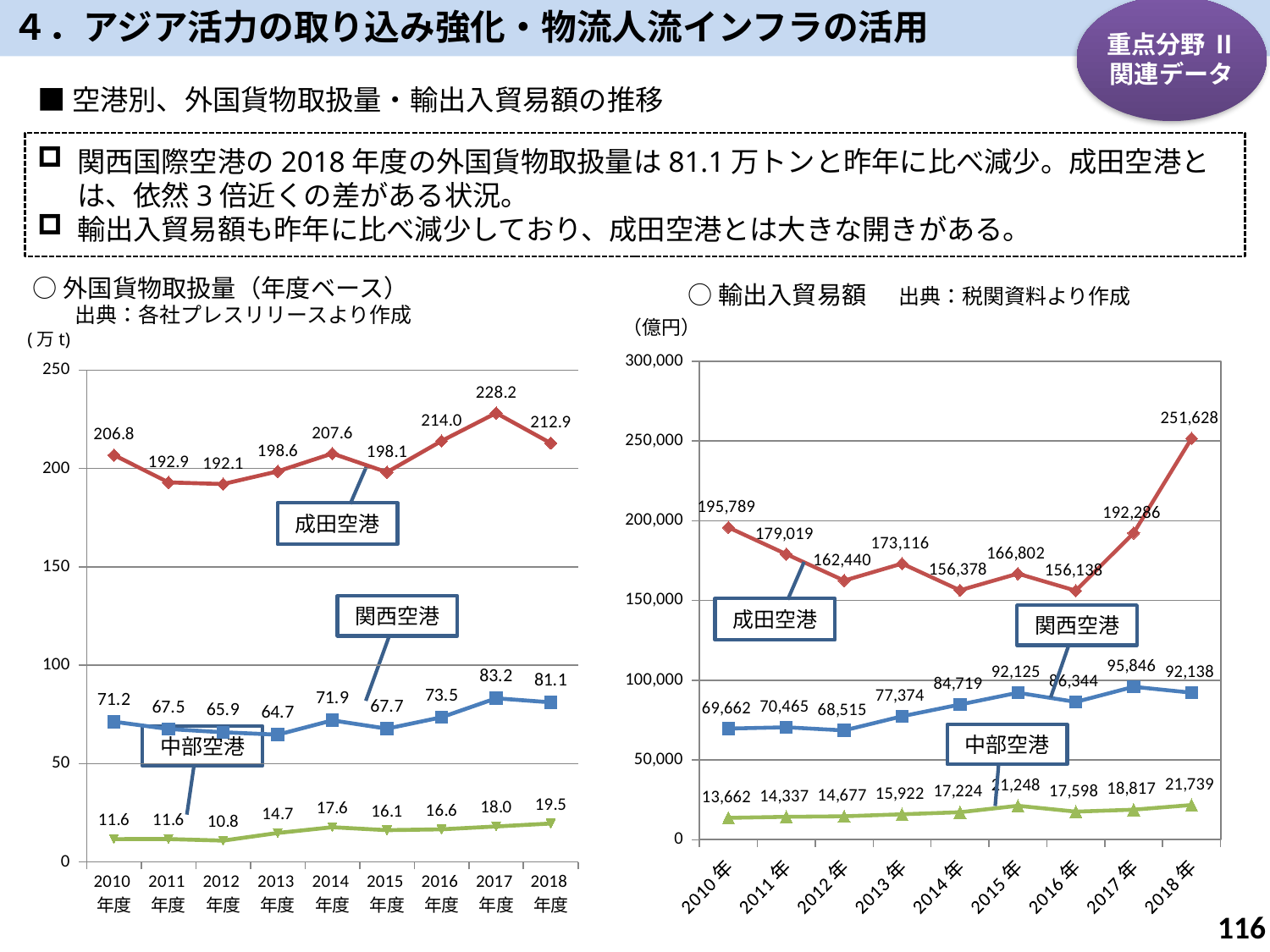
In the 外国貨物取扱量 chart on the left, what is the value for 成田空港 in 2017年度? 228.2 In the 外国貨物取扱量 chart on the left, what is the value for 関西空港 in 2018年度? 81.1 In the 輸出入貿易額 chart on the right, what unit is shown on the vertical axis? 億円 What type of chart is the 外国貨物取扱量 chart on the left? line chart In the 外国貨物取扱量 chart on the left, in which year is the value for 中部空港 lowest? 2012年度 In the 外国貨物取扱量 chart on the left, what is the difference between 成田空港 and 関西空港 in 2018年度? 131.8 In the 輸出入貿易額 chart on the right, what is the value for 成田空港 in 2018年? 251,628 In the 輸出入貿易額 chart on the right, which is larger for 関西空港: the value in 2017年 or the value in 2018年? 2017年 In the 外国貨物取扱量 chart on the left, in which year does 成田空港 reach its highest value? 2017年度 In the 輸出入貿易額 chart on the right, what is the value for 中部空港 in 2015年? 21,248 In the 輸出入貿易額 chart on the right, what is the difference between 成田空港 and 関西空港 in 2018年? 159,490 In the 外国貨物取扱量 chart on the left, how many years are plotted on the x axis? 9